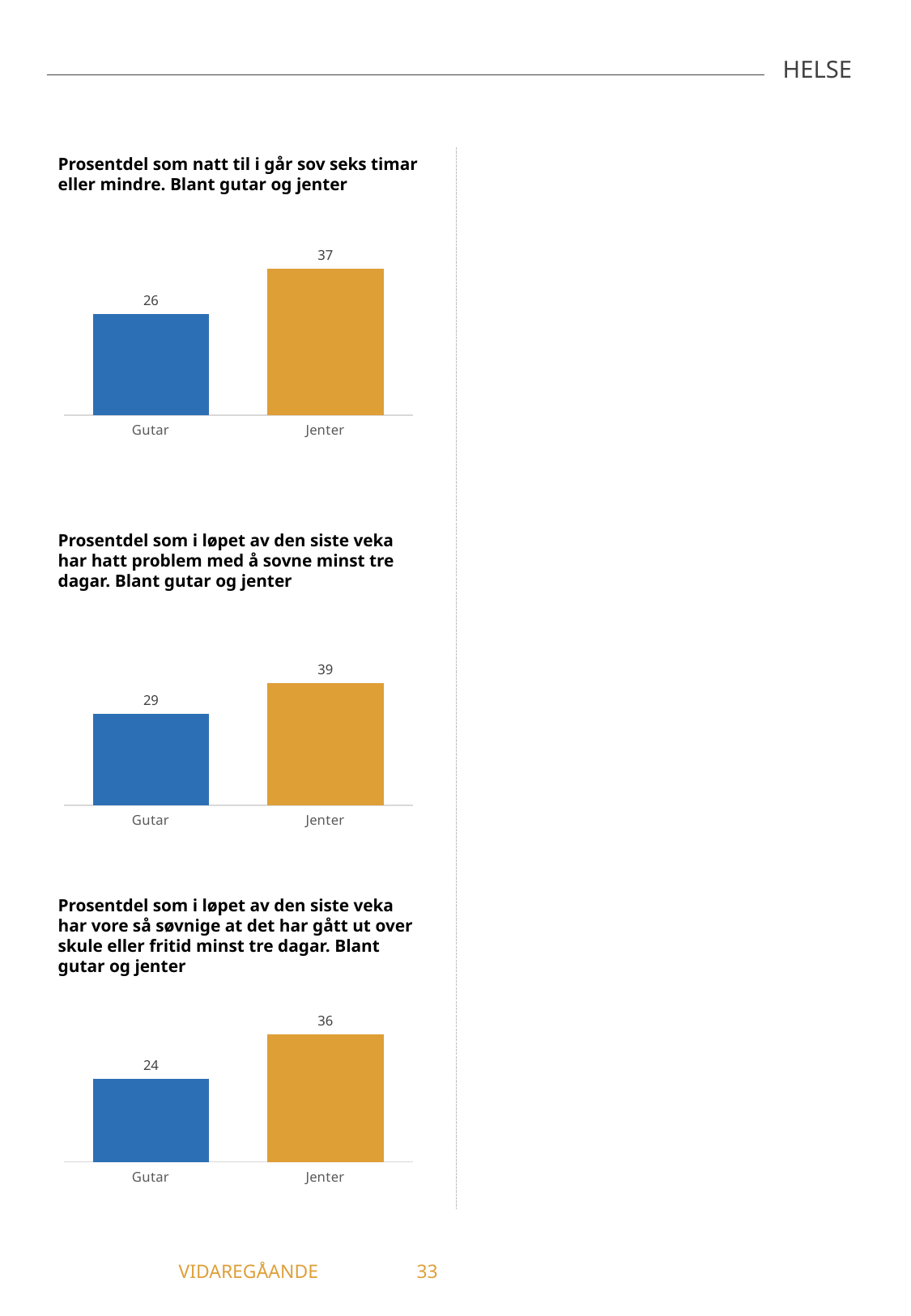
How many categories does the bottom chart (so sleepy it affected school or leisure) show? 2 In the middle chart (problems falling asleep at least three days), what is the value for Gutar? 29 In the top chart (sleeping six hours or less), what is the value for Gutar? 26 In the middle chart (problems falling asleep at least three days), which category is highest? Jenter In the top chart (sleeping six hours or less), what is the value for Jenter? 37 In the middle chart (problems falling asleep at least three days), what is the difference between Jenter and Gutar? 10 In the bottom chart (so sleepy it affected school or leisure), which category is lowest? Gutar In the top chart (sleeping six hours or less), which is larger, Gutar or Jenter? Jenter What kind of chart is the middle chart (problems falling asleep at least three days)? Bar chart In the bottom chart (so sleepy it affected school or leisure), what is the difference between Jenter and Gutar? 12 In the bottom chart (so sleepy it affected school or leisure), what is the value for Jenter? 36 In the top chart (sleeping six hours or less), what is the difference between Jenter and Gutar? 11